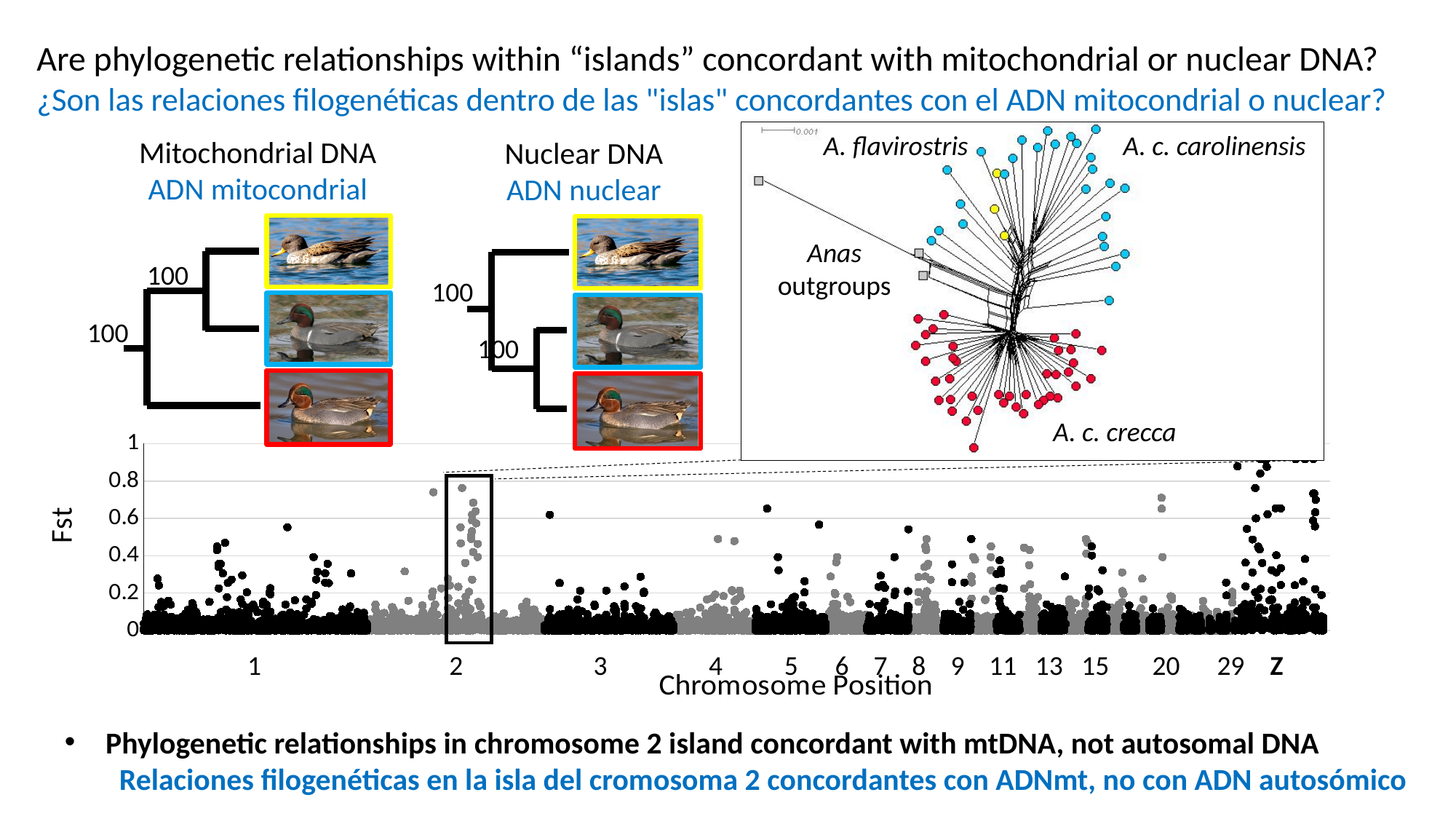
In the Fst plot, is the highest point for chromosome Z greater or less than 0.8? greater What kind of chart is the Fst plot at the bottom of the slide? scatter chart In the Fst plot, is the highest point for chromosome 3 greater or less than 0.8? less Which chromosome on the Fst plot is outlined with a black rectangle? 2 What is the label on the x axis of the Fst plot? Chromosome Position How many chromosome labels are shown along the x axis of the Fst plot? 15 What is the highest tick value shown on the y axis of the Fst plot? 1 In the Fst plot, is the highest point for chromosome 1 greater or less than 0.6? less In the Fst plot, which has a higher maximum Fst value, chromosome 1 or chromosome 2? chromosome 2 In the Fst plot, which chromosome has points reaching the highest Fst values, chromosome 2 or chromosome Z? Z What is the label on the y axis of the Fst plot? Fst